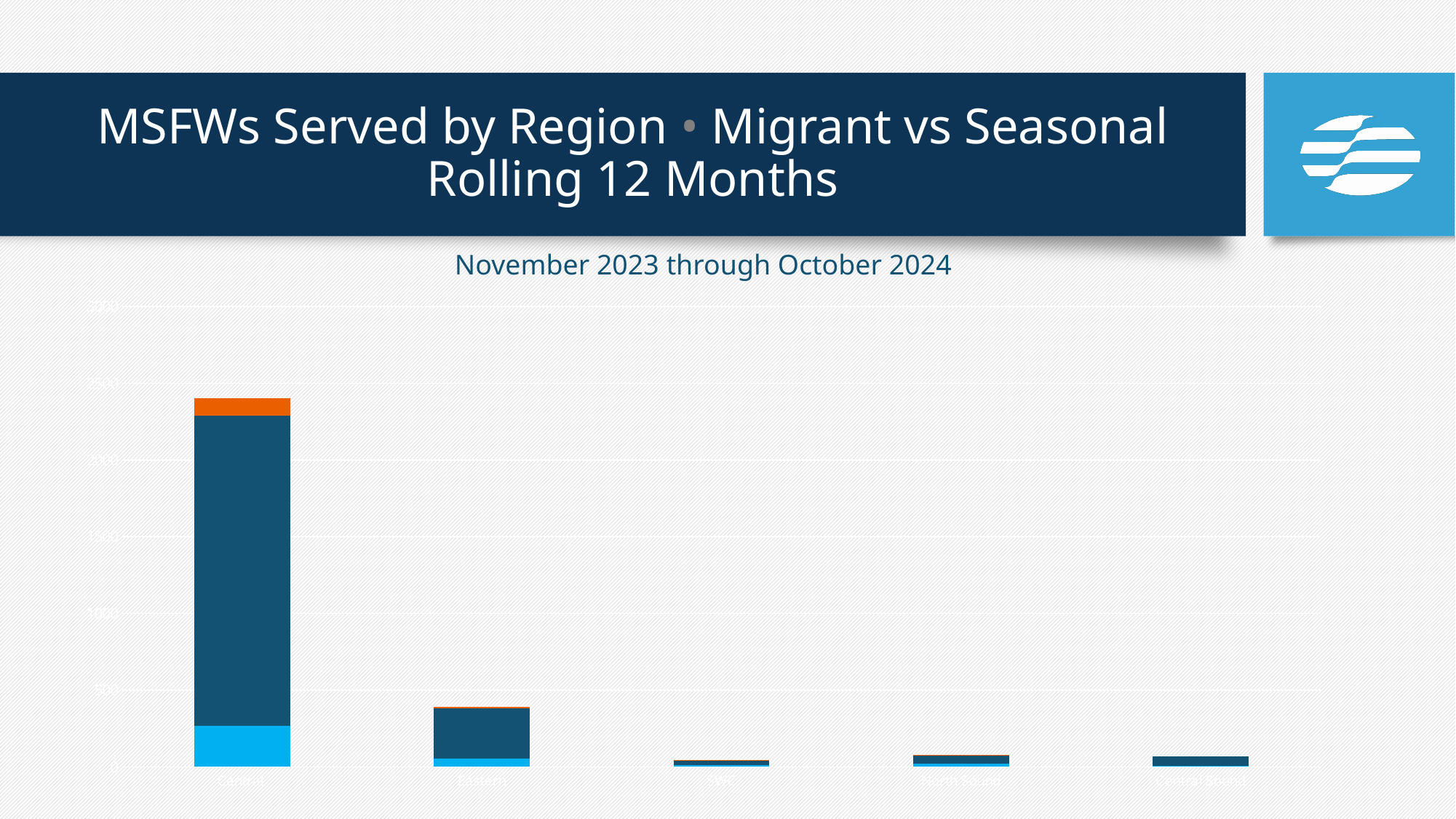
Which region has the lowest total bar in the chart? SWC Which region has a larger total bar, Central or Eastern? Central Is the total value for Central greater or less than 2000? greater Is the total value for Central greater or less than 2500? less Which region has the highest total bar in the chart? Central What is the title of the slide containing the chart? MSFWs Served by Region • Migrant vs Seasonal Rolling 12 Months Is the total value for Eastern greater or less than 500? less What kind of chart is shown on the slide? Stacked bar chart How many regions are shown on the x axis of the chart? 5 What time period does the chart's subtitle say the data covers? November 2023 through October 2024